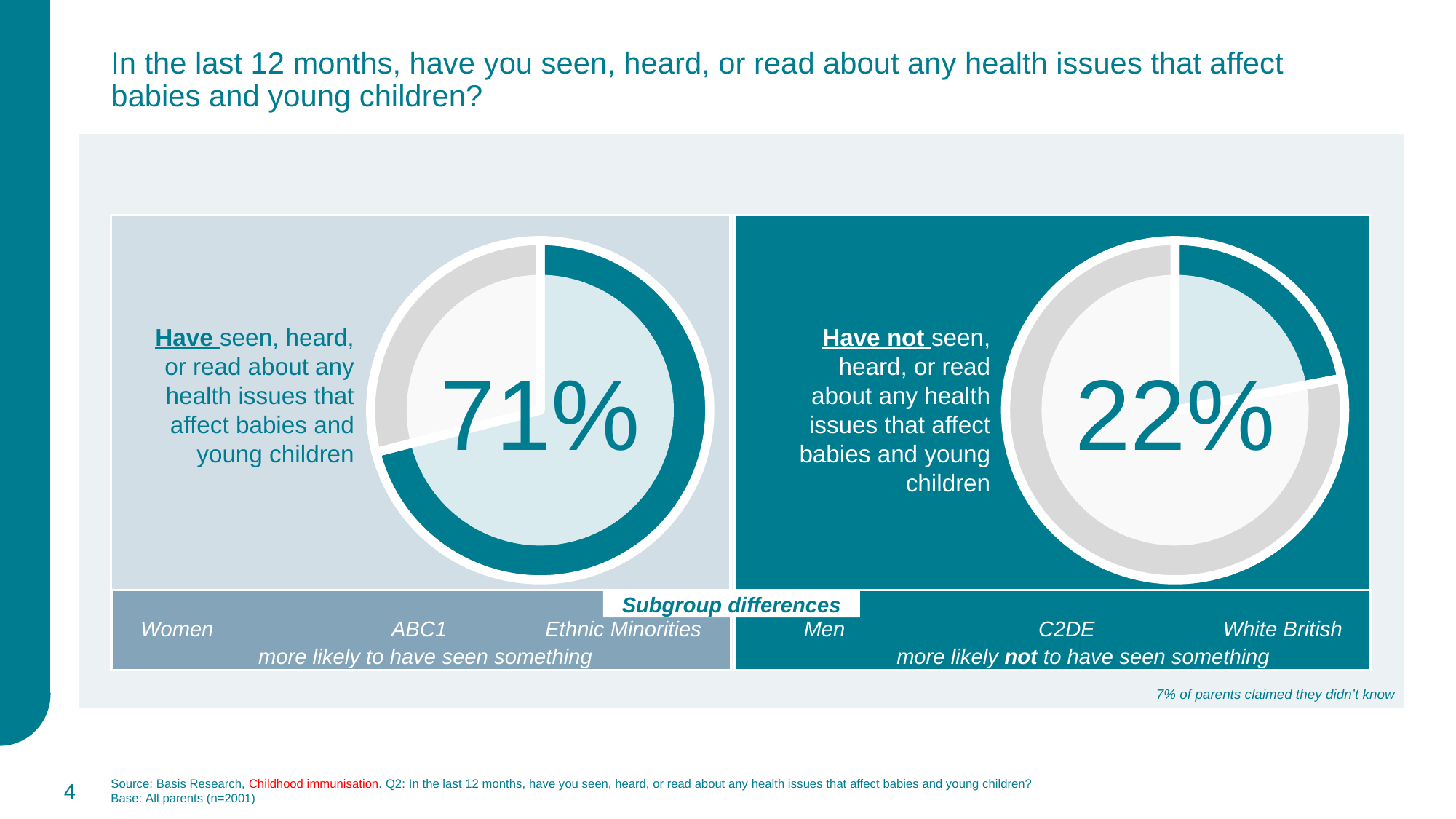
Which is larger: the share of parents who have seen something (left chart) or the share who have not (right chart)? Have seen (71%) What is the difference in percentage points between the left chart value (71%) and the right chart value (22%)? 49 percentage points On the left chart, what percentage of parents have seen, heard, or read about any health issues that affect babies and young children? 71% How many charts are shown on the slide? 2 On the right chart, what percentage of parents have not seen, heard, or read about any health issues that affect babies and young children? 22% Adding the left chart value (71%) and the right chart value (22%), what total percentage of parents gave a definite answer? 93% On the left chart, is the value for parents who have seen something greater or less than 50%? greater Which subgroups are listed under the left chart as more likely to have seen something? Women, ABC1, Ethnic Minorities According to the note below the charts, what percentage of parents claimed they didn't know? 7% What kind of chart is used on the left side of the slide? Doughnut (pie) chart On the right chart, is the value for parents who have not seen something greater or less than 50%? less What share of the left chart is taken up by the highlighted dark teal slice? 71%